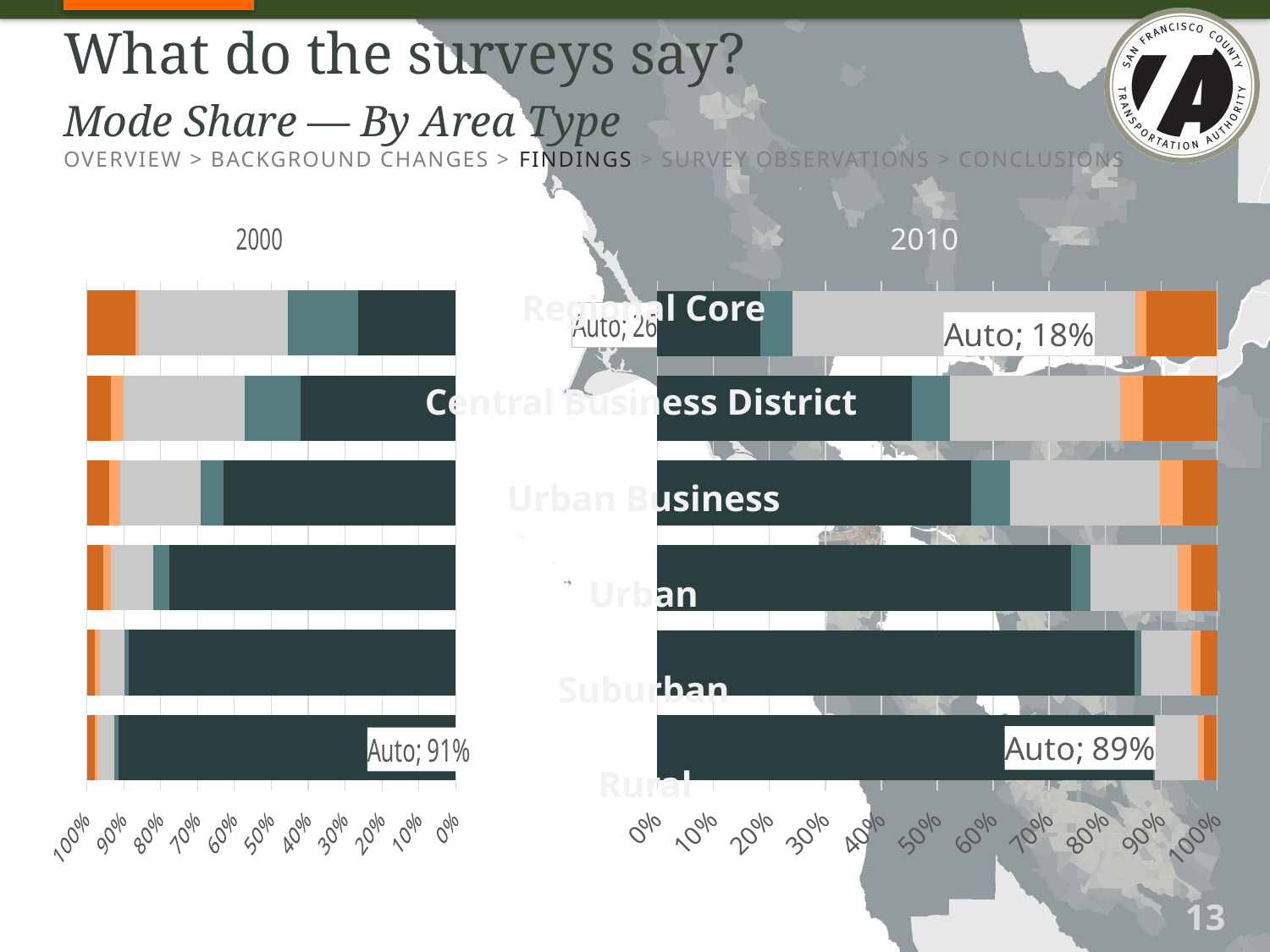
What is the title of the left chart? 2000 In the 2010 chart, what is the difference between the Auto share for Rural and for Regional Core? 71 percentage points In the 2010 chart, which is larger, the Auto share for Rural or for Regional Core? Rural In the 2010 chart, is the Auto share for Suburban greater or less than 80%? greater In the 2000 chart, what is the Auto share for Rural? 91% In the 2010 chart, what is the Auto share for Rural? 89% In the 2010 chart, what is the Auto share for Regional Core? 18% Comparing the Rural Auto labels, how much higher is the 2000 value than the 2010 value? 2 percentage points What kind of chart is the 2010 chart? Stacked bar chart How many area types are shown in the 2010 chart? 6 In the 2010 chart, which area type has the lowest Auto share? Regional Core In the 2010 chart, is the Auto share for Central Business District greater or less than 60%? less